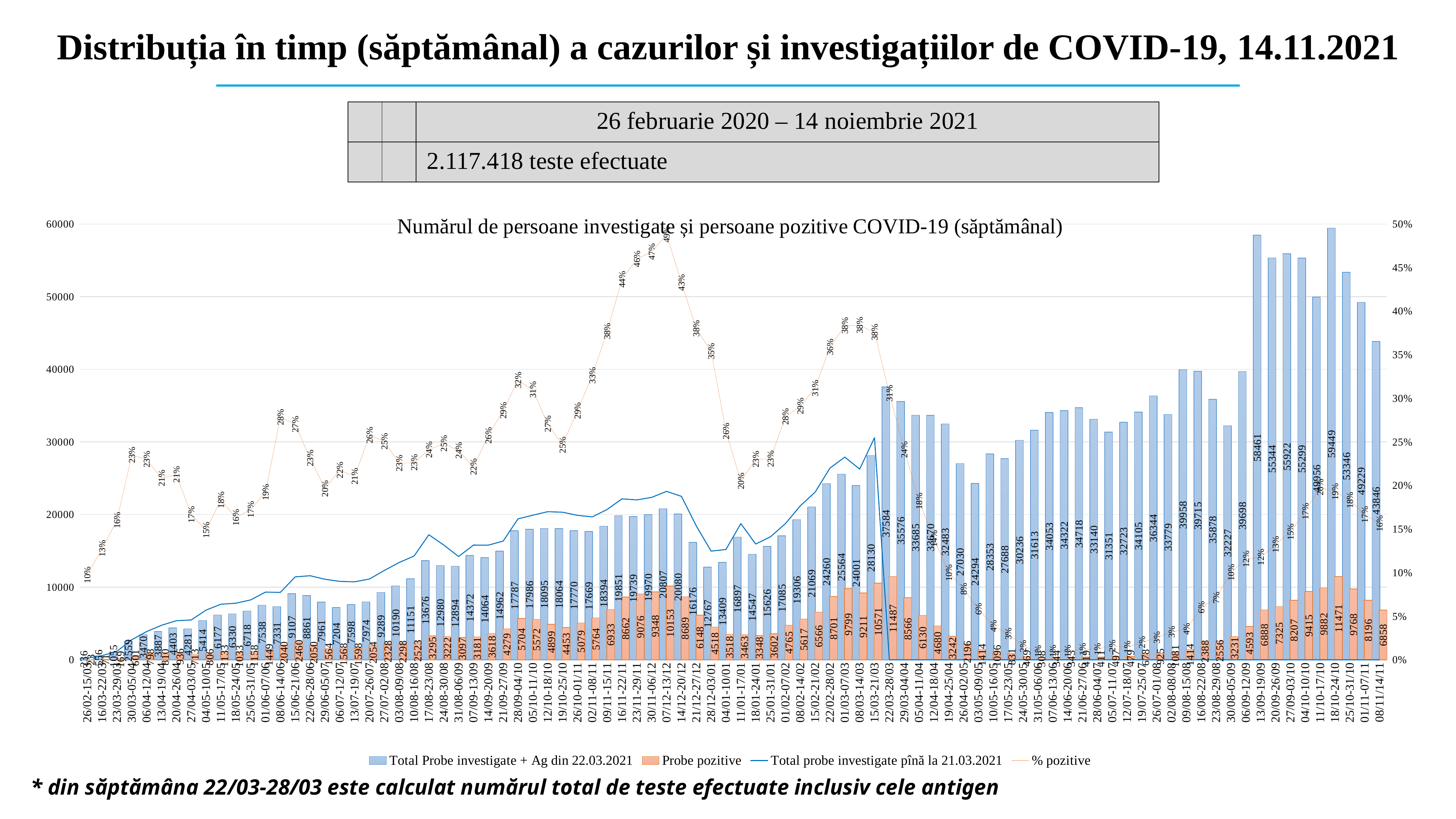
Which is larger: Probe pozitive for the week 22/03-28/03 or for the week 06/09-12/09? 22/03-28/03 What kind of chart is shown on the slide? Combined bar and line chart Which week has the highest % pozitive value? 07/12-13/12 Is the Total Probe investigate + Ag value for the week 06/09-12/09 greater or less than 50000? less What is the title of the chart? Numărul de persoane investigate și persoane pozitive COVID-19 (săptămânal) What is the % pozitive value for the week 22/03-28/03? 31% What is the % pozitive value for the week 07/12-13/12? 49% How many series does the chart legend list? 4 Which week has the highest Total Probe investigate + Ag value? 18/10-24/10 What is the difference between Total Probe investigate + Ag and Probe pozitive for the week 08/11-14/11? 36988 What is the value of Total Probe investigate + Ag for the week 18/10-24/10? 59449 What is the value of Probe pozitive for the week 08/11-14/11? 6858